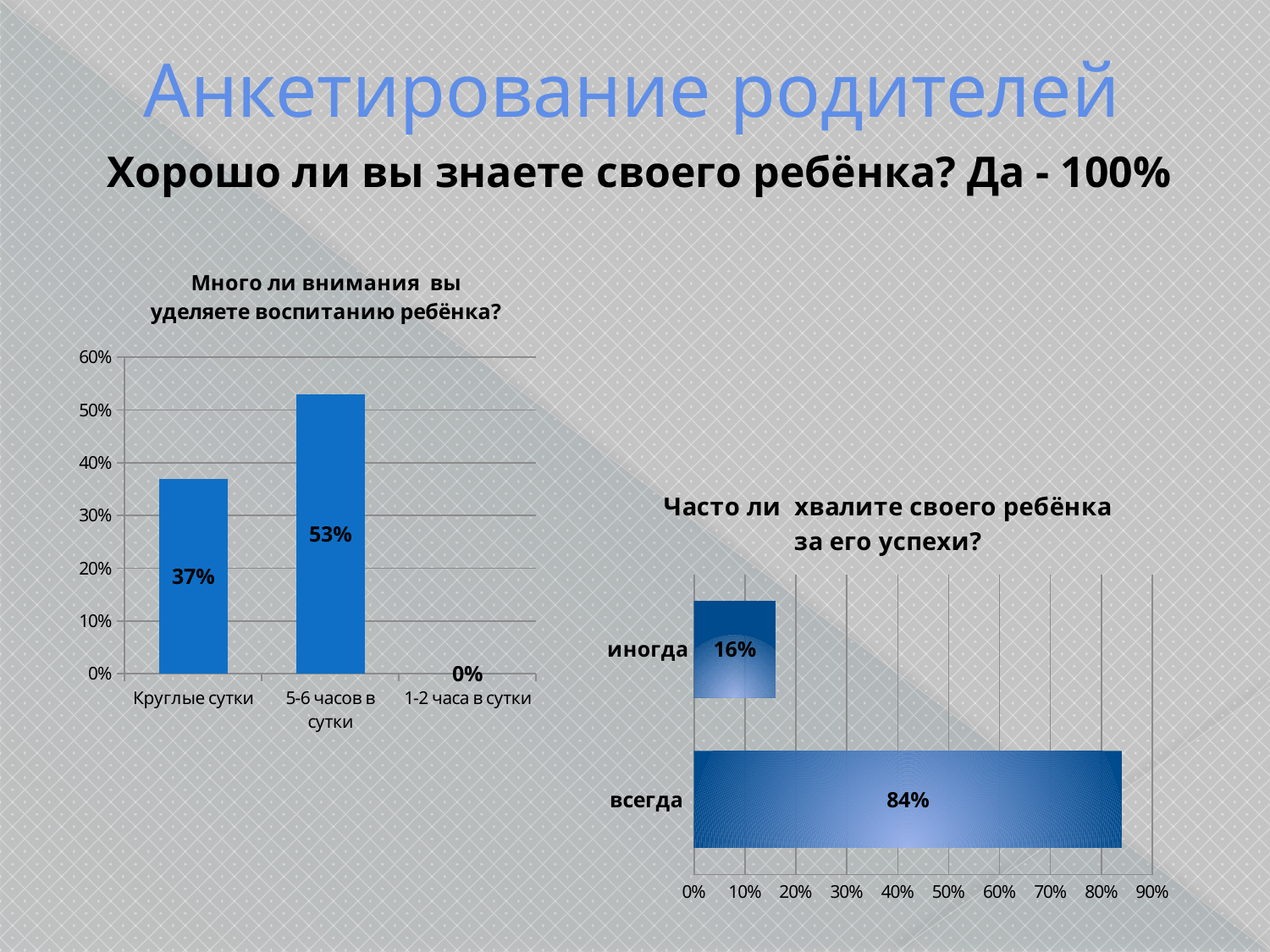
In the chart titled "Много ли внимания вы уделяете воспитанию ребёнка?", how many categories are shown? 3 In the chart titled "Много ли внимания вы уделяете воспитанию ребёнка?", which category has the lowest value? 1-2 часа в сутки What kind of chart is the one titled "Часто ли хвалите своего ребёнка за его успехи?"? Bar chart In the chart titled "Много ли внимания вы уделяете воспитанию ребёнка?", what is the value for "Круглые сутки"? 37% In the chart titled "Много ли внимания вы уделяете воспитанию ребёнка?", which category has the highest value? 5-6 часов в сутки In the chart titled "Много ли внимания вы уделяете воспитанию ребёнка?", what is the value for "5-6 часов в сутки"? 53% In the chart titled "Много ли внимания вы уделяете воспитанию ребёнка?", what is the value for "1-2 часа в сутки"? 0% In the chart titled "Часто ли хвалите своего ребёнка за его успехи?", what is the value for "всегда"? 84% In the chart titled "Много ли внимания вы уделяете воспитанию ребёнка?", what is the difference between the values for "5-6 часов в сутки" and "Круглые сутки"? 16% In the chart titled "Часто ли хвалите своего ребёнка за его успехи?", what is the value for "иногда"? 16% In the chart titled "Часто ли хвалите своего ребёнка за его успехи?", what is the difference between the values for "всегда" and "иногда"? 68% In the chart titled "Часто ли хвалите своего ребёнка за его успехи?", which is larger, "всегда" or "иногда"? всегда